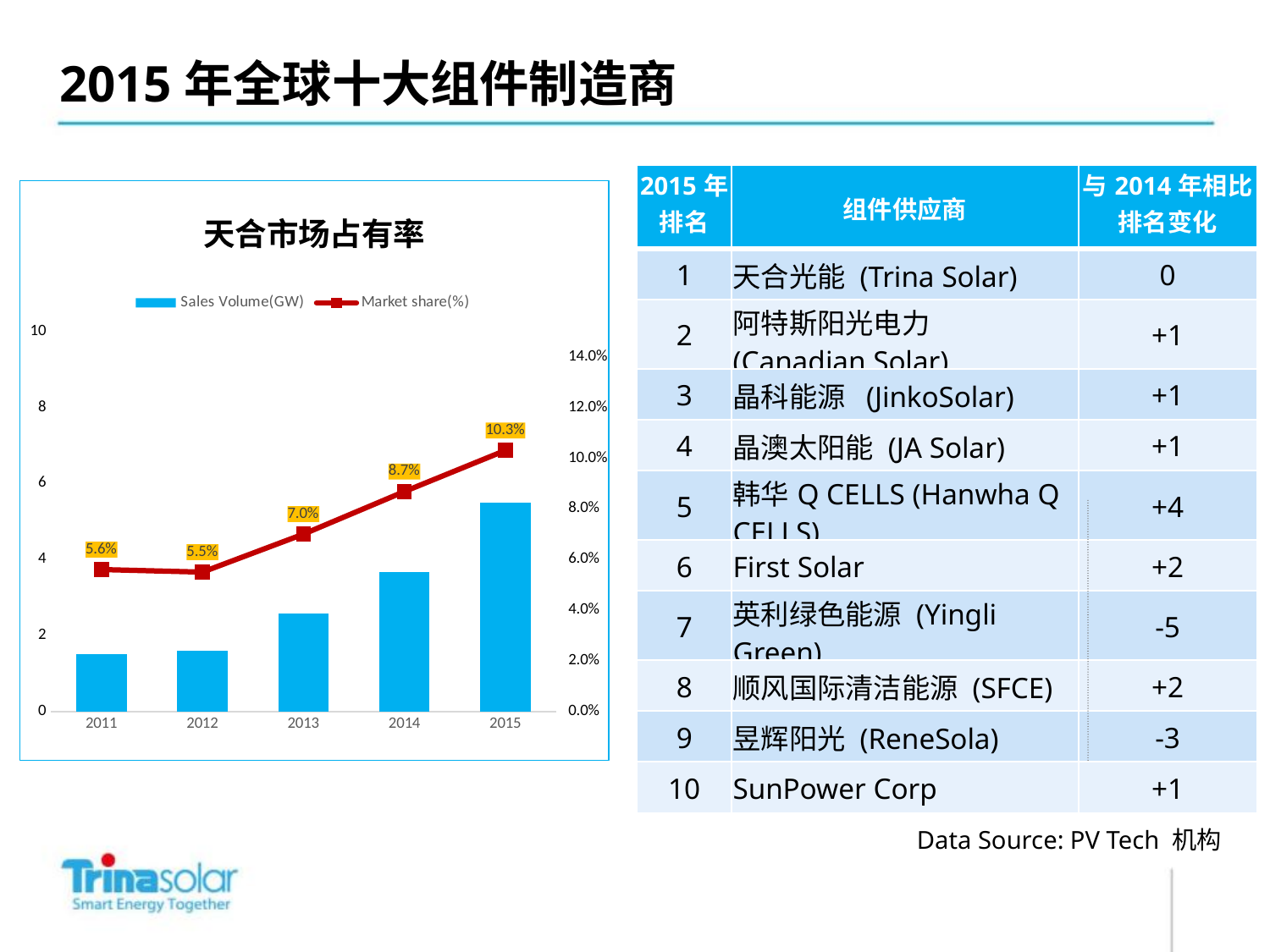
Is the sales volume for 2015 greater or less than 4 GW? greater How many years are shown on the x axis of the 天合市场占有率 chart? 5 Which year has the larger market share, 2013 or 2014? 2014 What is the market share for 2015 in the 天合市场占有率 chart? 10.3% Which year has the lowest market share in the 天合市场占有率 chart? 2012 Which year has the highest market share in the 天合市场占有率 chart? 2015 Is the sales volume for 2011 greater or less than 2 GW? less How many series does the legend of the 天合市场占有率 chart list? 2 Does the sales volume rise or fall from 2012 to 2015 in the 天合市场占有率 chart? rise What is the market share for 2013 in the 天合市场占有率 chart? 7.0% What is the market share for 2011 in the 天合市场占有率 chart? 5.6% What is the difference in market share between 2015 and 2014 in the 天合市场占有率 chart? 1.6%